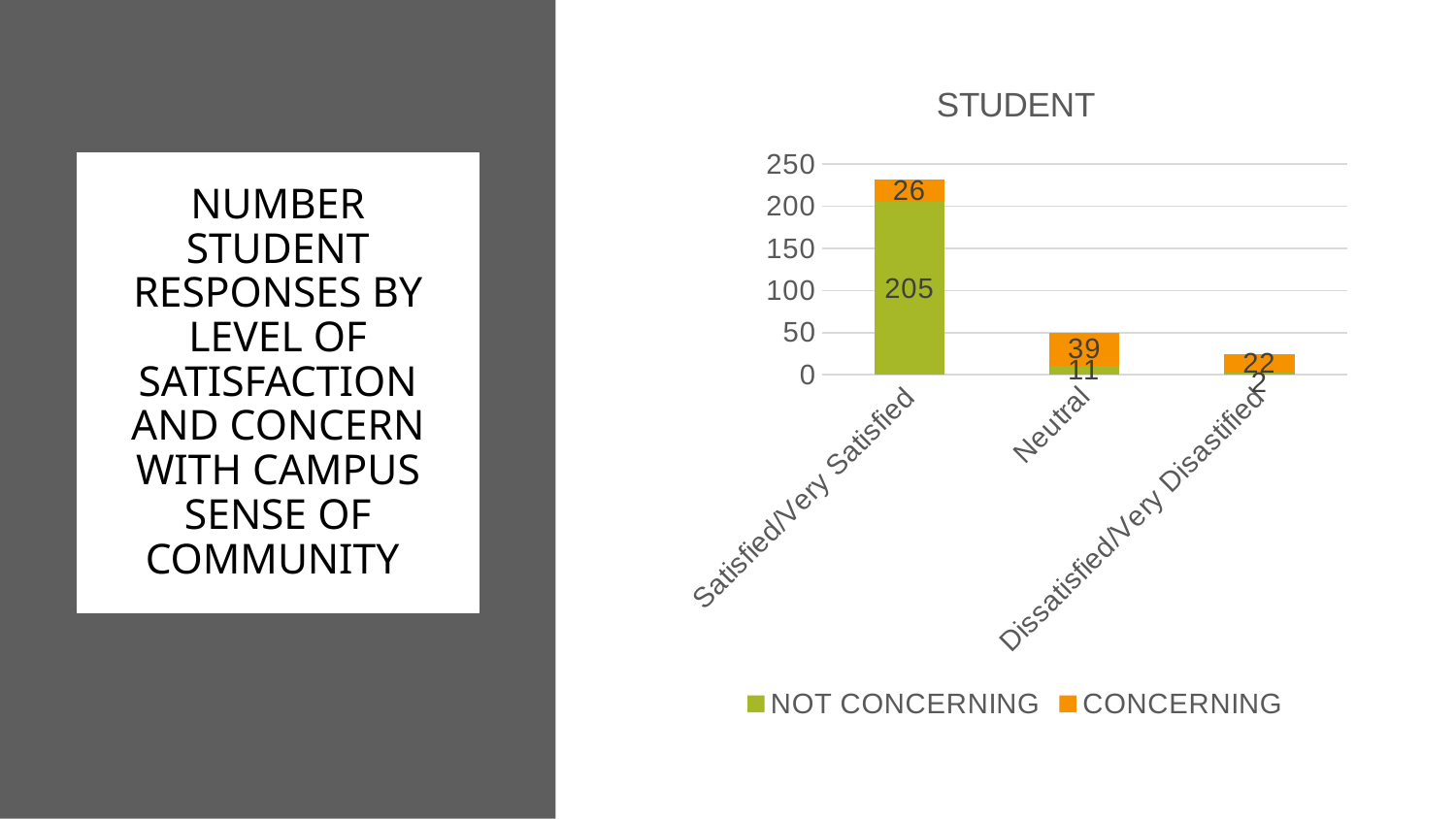
What is the difference between the NOT CONCERNING and CONCERNING values for Satisfied/Very Satisfied? 179 Which category has the highest NOT CONCERNING value? Satisfied/Very Satisfied How many categories are shown on the x axis? 3 Is the CONCERNING value larger for Neutral or for Satisfied/Very Satisfied? Neutral What is the title of the chart? STUDENT What is the CONCERNING value for Dissatisfied/Very Disastified? 22 How many series does the legend list? 2 What is the total of the stacked bar for Neutral? 50 What type of chart is shown on the slide? stacked bar chart What is the CONCERNING value for Neutral? 39 What is the NOT CONCERNING value for Satisfied/Very Satisfied? 205 Which category has the lowest CONCERNING value? Dissatisfied/Very Disastified